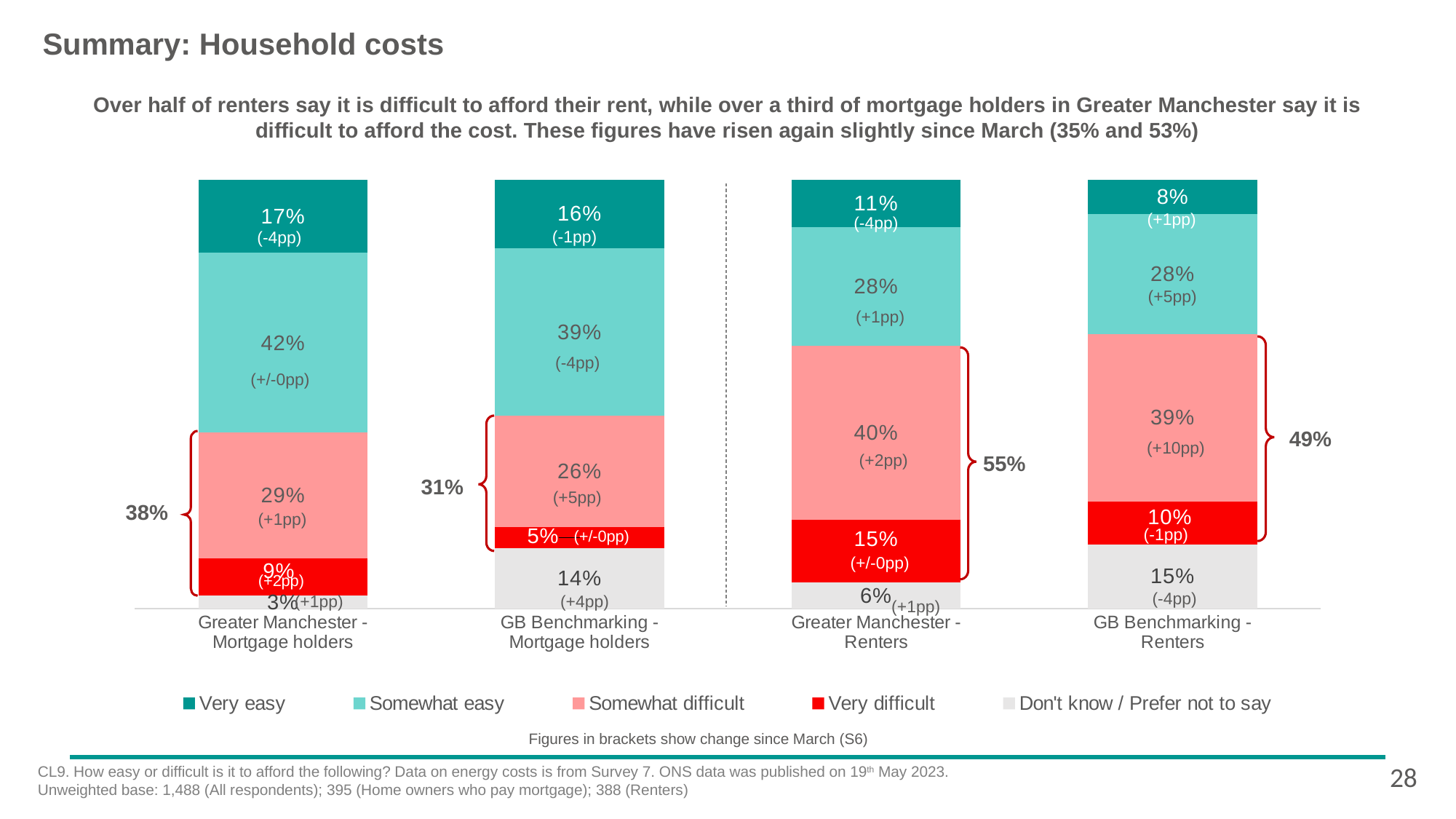
What is the Don't know / Prefer not to say value for GB Benchmarking - Mortgage holders? 14% What is the difference between the Somewhat easy values for Greater Manchester - Mortgage holders and GB Benchmarking - Mortgage holders? 3 percentage points What kind of chart is shown on the slide? Stacked bar chart What is the combined share of Somewhat difficult and Very difficult for Greater Manchester - Renters, as shown by the bracket? 55% What is the Very easy value for GB Benchmarking - Renters? 8% How many categories are shown on the x axis? 4 Which is larger: the Very difficult value for Greater Manchester - Renters or for GB Benchmarking - Renters? Greater Manchester - Renters What is the Very difficult value for Greater Manchester - Renters? 15% Which category has the highest Somewhat difficult value? Greater Manchester - Renters Which category has the lowest Very easy value? GB Benchmarking - Renters What percentage of Greater Manchester mortgage holders say it is somewhat easy to afford their mortgage? 42% How many series does the legend list? 5